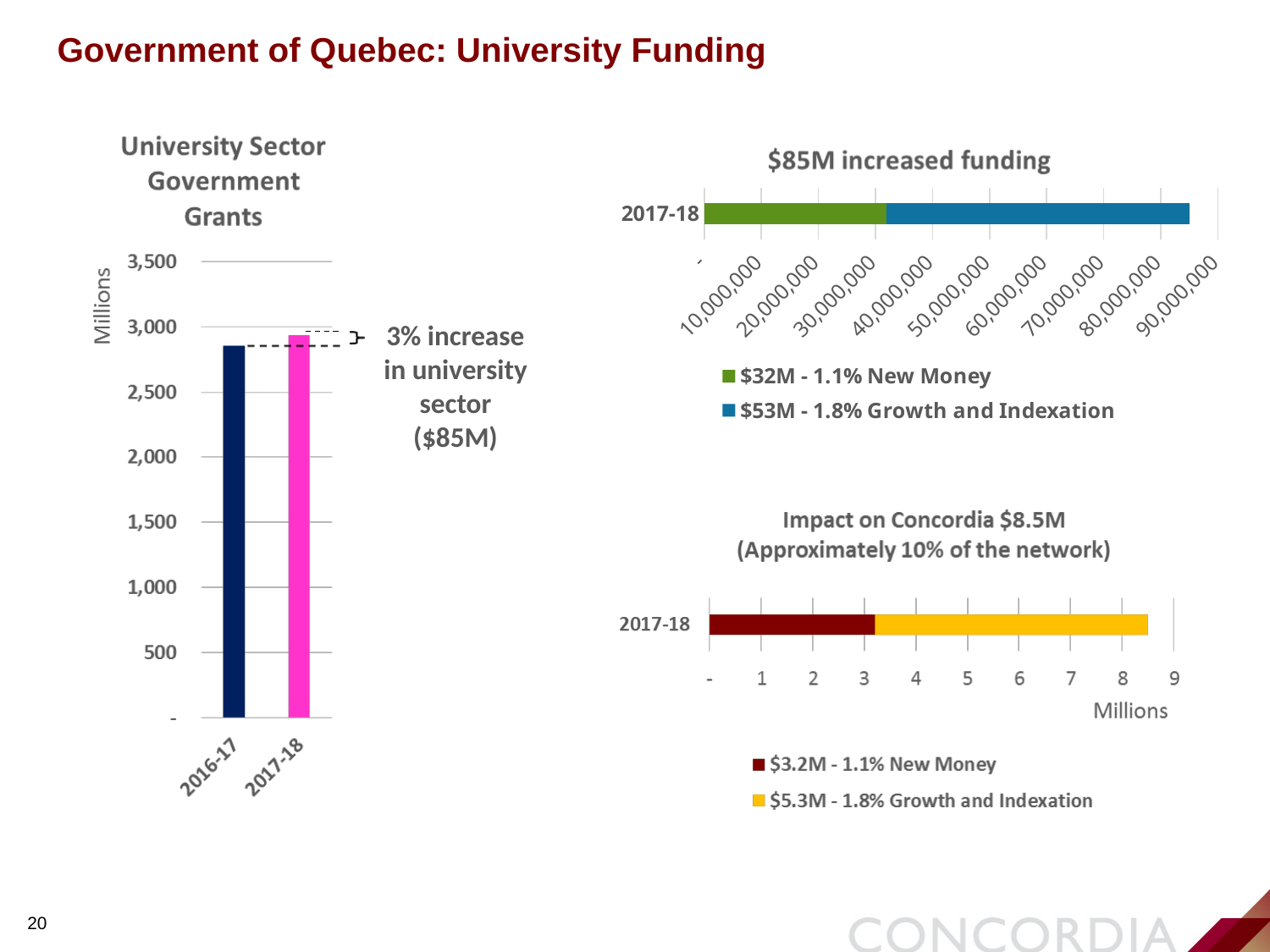
In the "University Sector Government Grants" chart, which year has the higher bar? 2017-18 In the "$85M increased funding" chart, how much is the New Money segment according to the legend? $32M What kind of chart is the "University Sector Government Grants" chart? bar chart In the "$85M increased funding" chart, which segment is larger, New Money or Growth and Indexation? Growth and Indexation How many categories are shown on the x axis of the "University Sector Government Grants" chart? 2 How many series does the legend of the "Impact on Concordia $8.5M" chart list? 2 In the "Impact on Concordia $8.5M" chart, what colour is the New Money segment? dark red In the "University Sector Government Grants" chart, do the values rise or fall from 2016-17 to 2017-18? rise In the "University Sector Government Grants" chart, is the value for 2016-17 greater or less than 2,500? greater In the "$85M increased funding" chart, how much is the Growth and Indexation segment according to the legend? $53M In the "Impact on Concordia $8.5M" chart, what is the difference between the Growth and Indexation segment and the New Money segment? $2.1M In the "University Sector Government Grants" chart, is the value for 2017-18 greater or less than 3,000? less